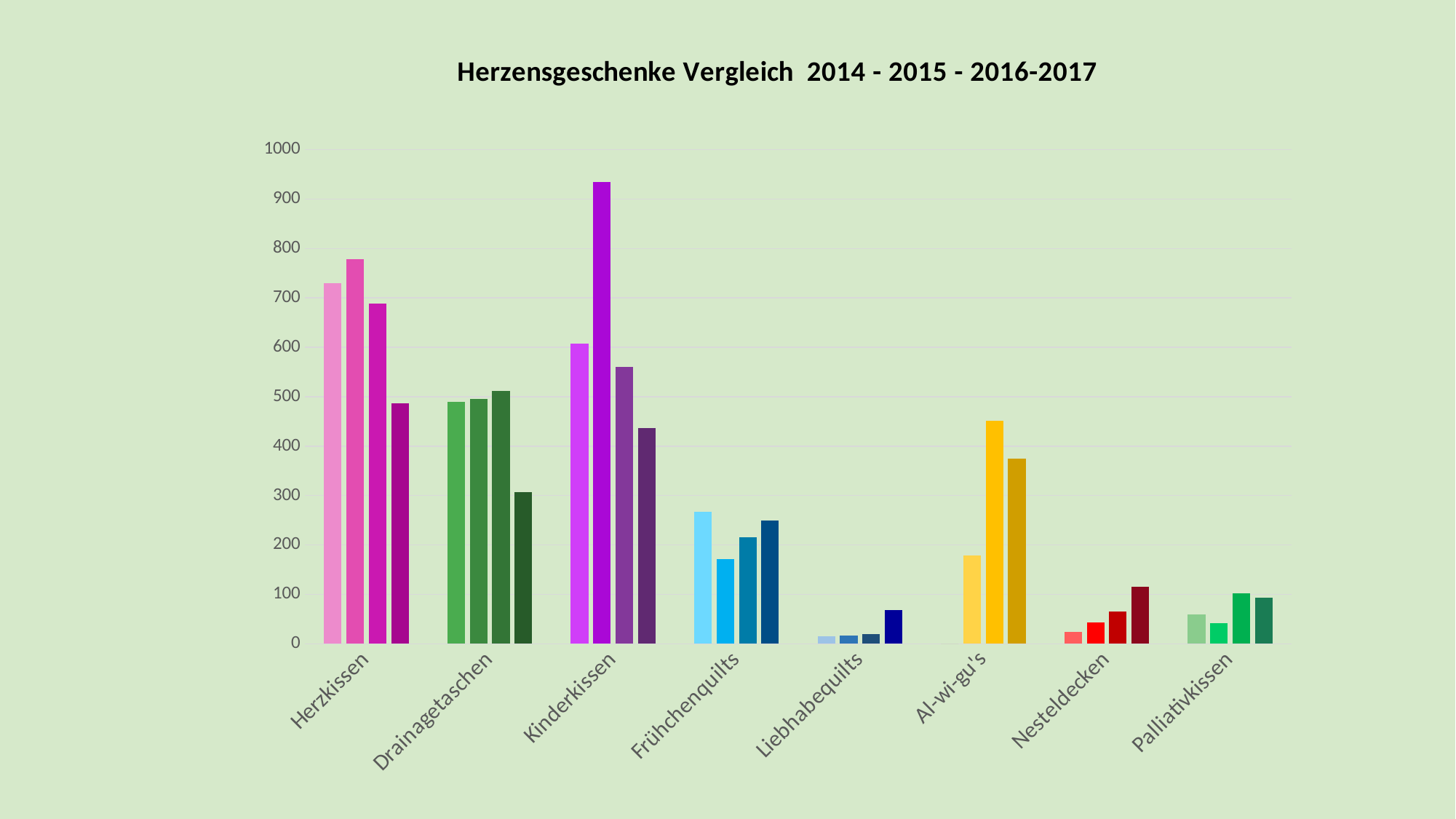
Is the tallest bar for Al-wi-gu's greater or less than 400? greater Is the tallest bar for Kinderkissen greater or less than 900? greater Do the bars for Nesteldecken rise or fall from left to right within the group? rise What kind of chart is shown on the slide? bar chart Which category contains the tallest bar in the chart? Kinderkissen Which is taller: the tallest bar for Al-wi-gu's or the tallest bar for Frühchenquilts? Al-wi-gu's Which category has the lowest bars overall? Liebhabequilts How many categories are shown on the x axis? 8 Is the tallest bar for Frühchenquilts greater or less than 300? less What is the title of the chart? Herzensgeschenke Vergleich 2014 - 2015 - 2016-2017 Which is taller: the tallest bar for Herzkissen or the tallest bar for Drainagetaschen? Herzkissen